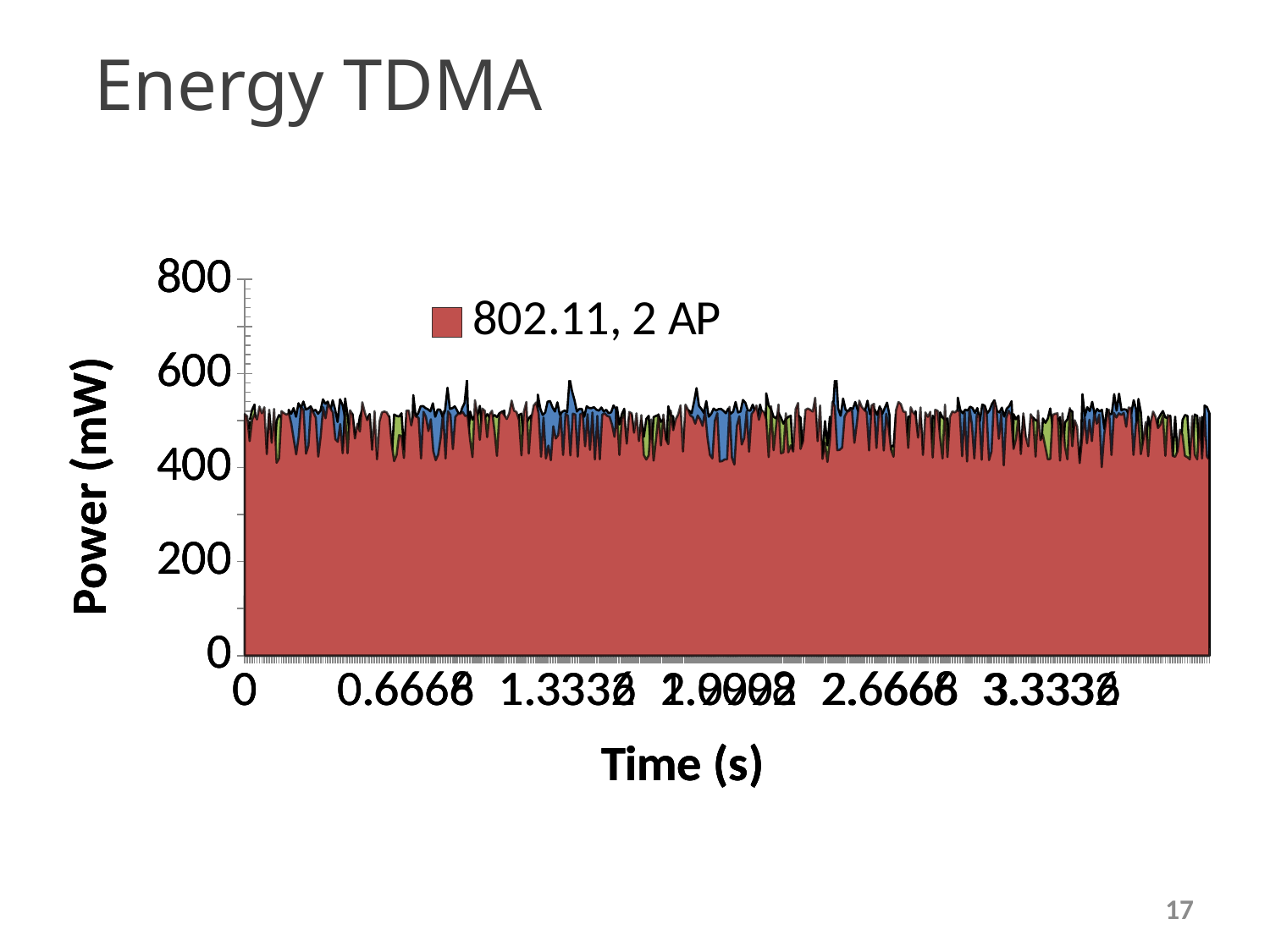
Is the power value near 2 s greater or less than 800? less Is the highest power value plotted greater or less than 800? less Is the power value at time 0 greater or less than 200? greater What is the series name shown in the chart's legend? 802.11, 2 AP What kind of chart is shown on the slide? Area chart Does the power rise, fall, or stay roughly flat as time increases along the x axis? Stays roughly flat What is the label of the vertical axis? Power (mW) How many series does the chart's legend list? 1